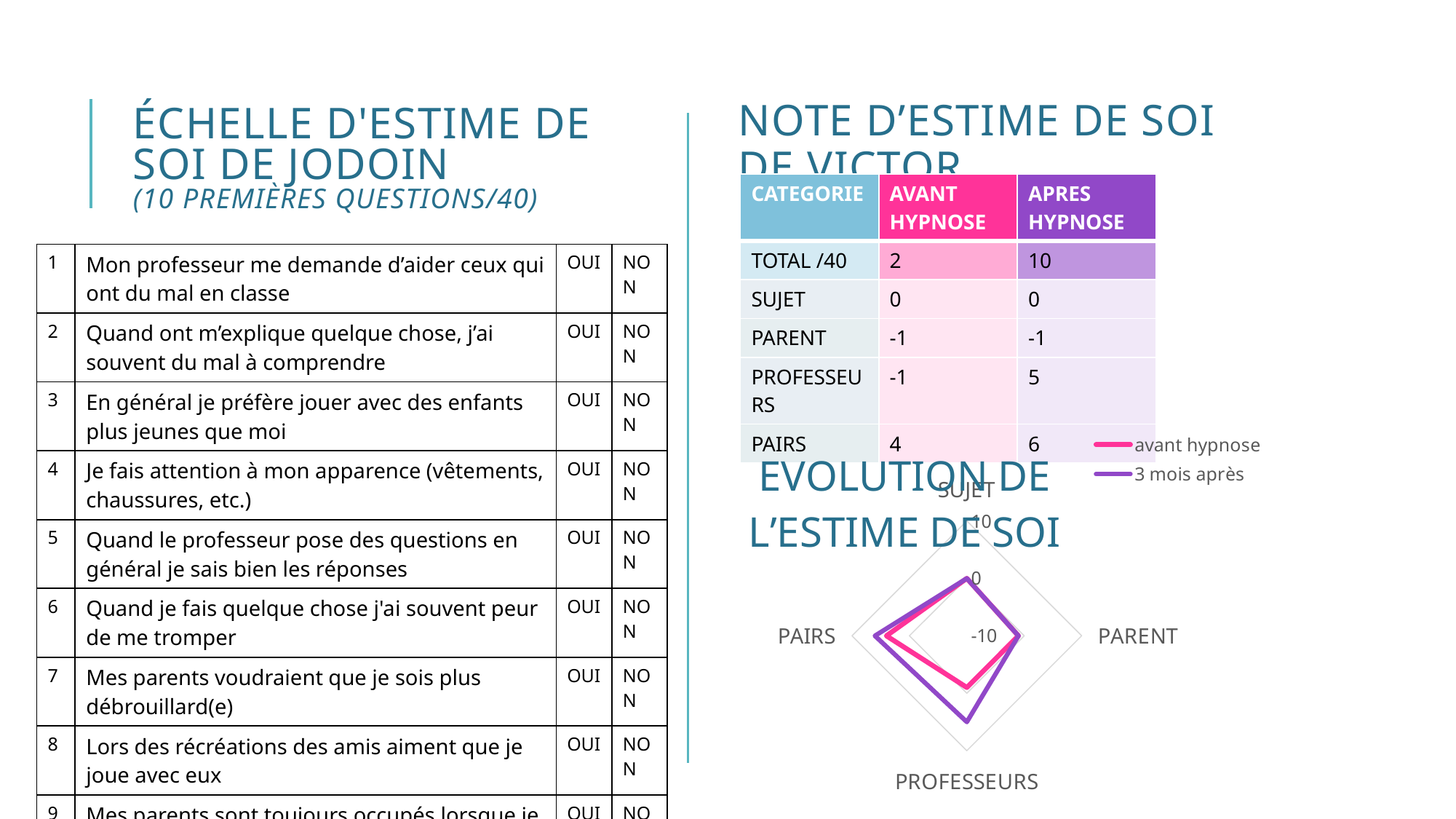
What is the lowest axis tick value shown on the "EVOLUTION DE L'ESTIME DE SOI" radar chart? -10 In the "EVOLUTION DE L'ESTIME DE SOI" chart, is the value for PAIRS in the "avant hypnose" series greater or less than 0? greater How many series does the legend of the "EVOLUTION DE L'ESTIME DE SOI" chart list? 2 In the "EVOLUTION DE L'ESTIME DE SOI" chart, which series has the larger value for PROFESSEURS, "avant hypnose" or "3 mois après"? 3 mois après What is the highest axis tick value shown on the "EVOLUTION DE L'ESTIME DE SOI" radar chart? 10 Which category is at the top of the "EVOLUTION DE L'ESTIME DE SOI" radar chart? SUJET In the "EVOLUTION DE L'ESTIME DE SOI" chart, which category has the highest value for the "avant hypnose" series? PAIRS What kind of chart is shown under the title "EVOLUTION DE L'ESTIME DE SOI"? radar chart What are the two series named in the legend of the "EVOLUTION DE L'ESTIME DE SOI" chart? avant hypnose, 3 mois après How many categories (axes) does the "EVOLUTION DE L'ESTIME DE SOI" radar chart have? 4 In the "EVOLUTION DE L'ESTIME DE SOI" chart, is the value for PROFESSEURS in the "3 mois après" series greater or less than 0? greater In the "EVOLUTION DE L'ESTIME DE SOI" chart, is the value for PROFESSEURS in the "3 mois après" series greater or less than 10? less